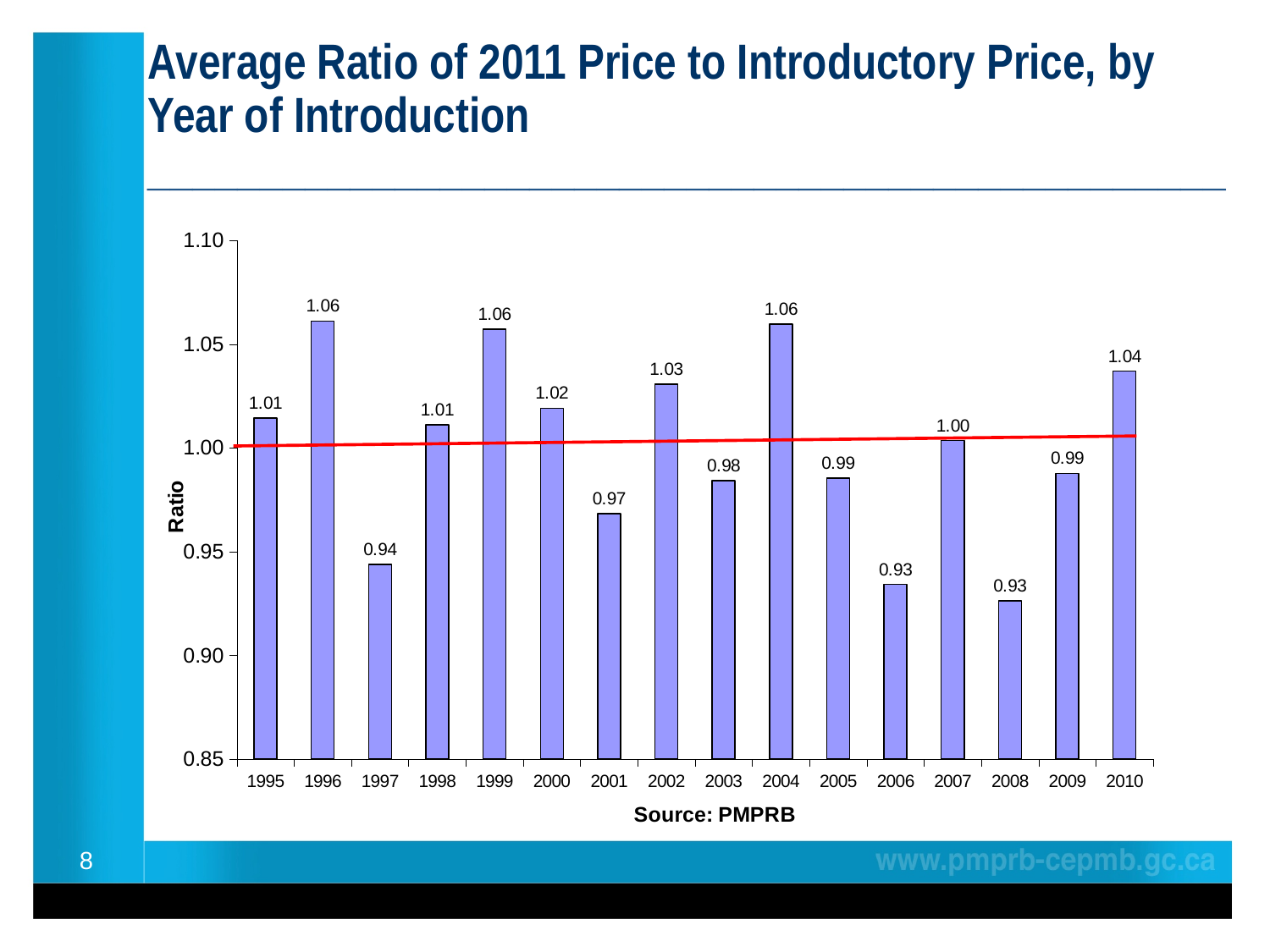
What is the average ratio for drugs introduced in 1997? 0.94 What is the average ratio for the 2010 year of introduction? 1.04 Is the value for 2010 greater or less than 1.00? greater What is the label on the vertical axis of the chart? Ratio Is the value for 1997 greater or less than 1.00? less What is the difference between the ratio for 1996 and the ratio for 1997? 0.12 What value is shown for 2007? 1.00 What kind of chart is shown on the slide? Bar chart What is the ratio shown for 2001? 0.97 What is the difference between the ratio for 2010 and the ratio for 2008? 0.11 How many years of introduction are shown on the x axis? 16 Which year has the larger ratio, 2002 or 2003? 2002